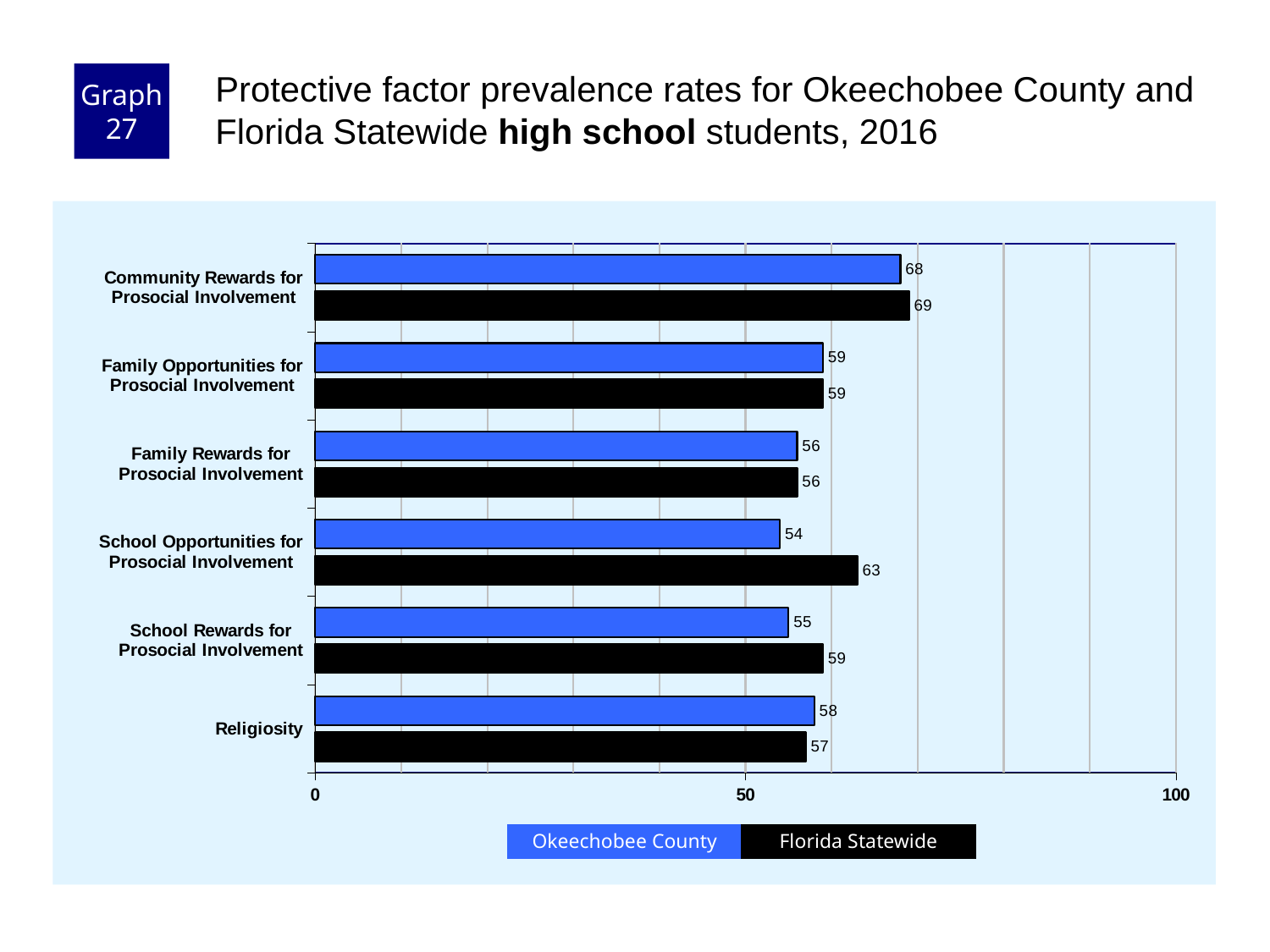
What is the Okeechobee County value for Community Rewards for Prosocial Involvement? 68 What is the Florida Statewide value for Religiosity? 57 How many protective factor categories are shown on the chart? 6 Is the Okeechobee County value for Family Rewards for Prosocial Involvement greater or less than 50? greater Which category has the highest Okeechobee County value? Community Rewards for Prosocial Involvement Which category has the lowest Okeechobee County value? School Opportunities for Prosocial Involvement For School Rewards for Prosocial Involvement, which is larger: the Okeechobee County value or the Florida Statewide value? Florida Statewide How many series does the legend list? 2 What is the difference between the Florida Statewide and Okeechobee County values for School Opportunities for Prosocial Involvement? 9 Which colour represents Florida Statewide in the chart? black What is the Florida Statewide value for School Opportunities for Prosocial Involvement? 63 What kind of chart is shown on the slide? bar chart